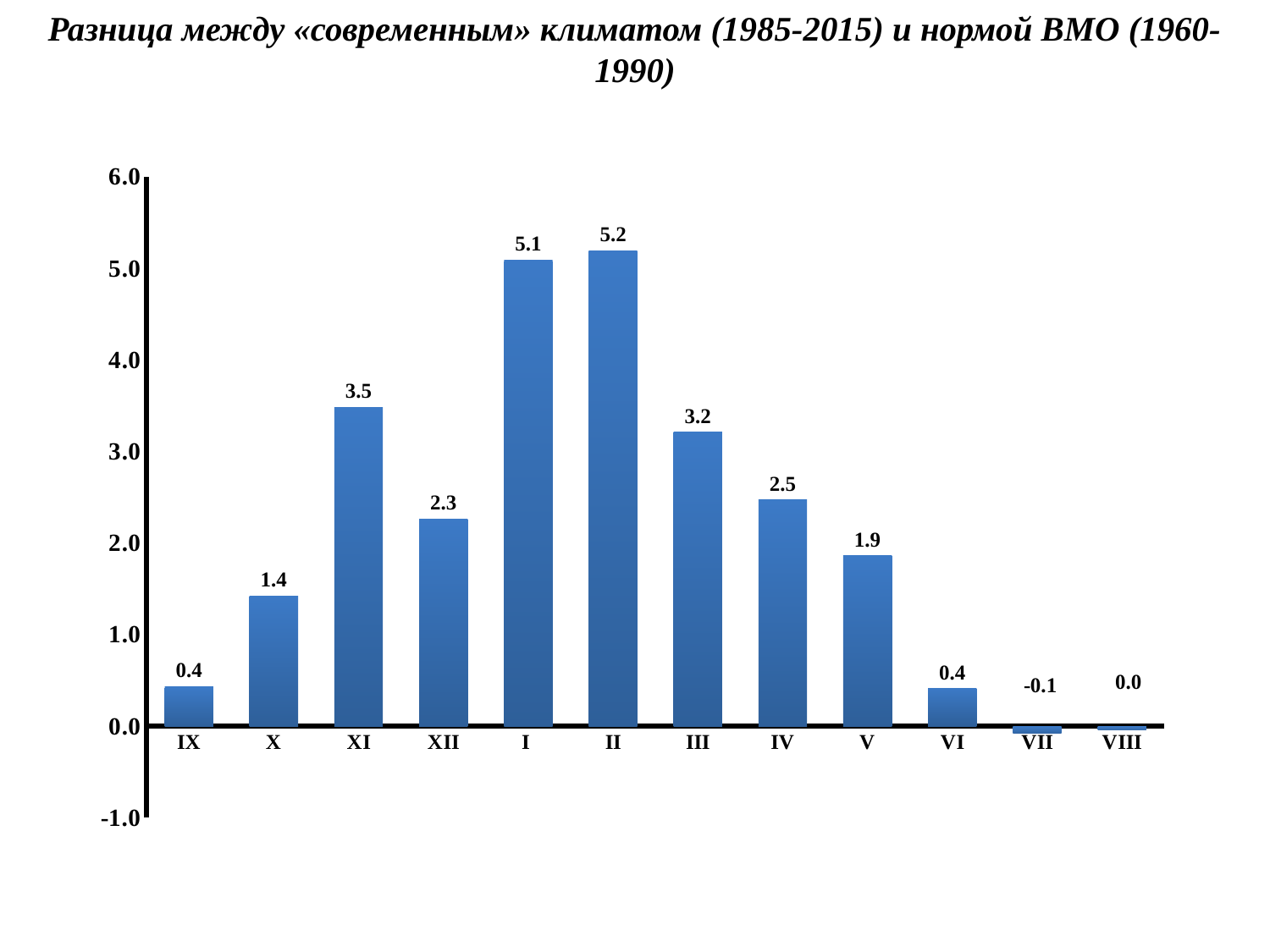
What kind of chart is this? bar chart Which month has the highest value? II Which is larger, the value for III or the value for IV? III What is the first month label on the x axis? IX What is the value for month XII? 2.3 Do the values rise or fall from II to VIII along the x axis? fall What is the value for month VII? -0.1 Is the value for I greater or less than 4.0? greater What is the difference between the values for XI and X? 2.1 Which month has the lowest value? VII What is the value for month II? 5.2 How many months are shown on the x axis? 12